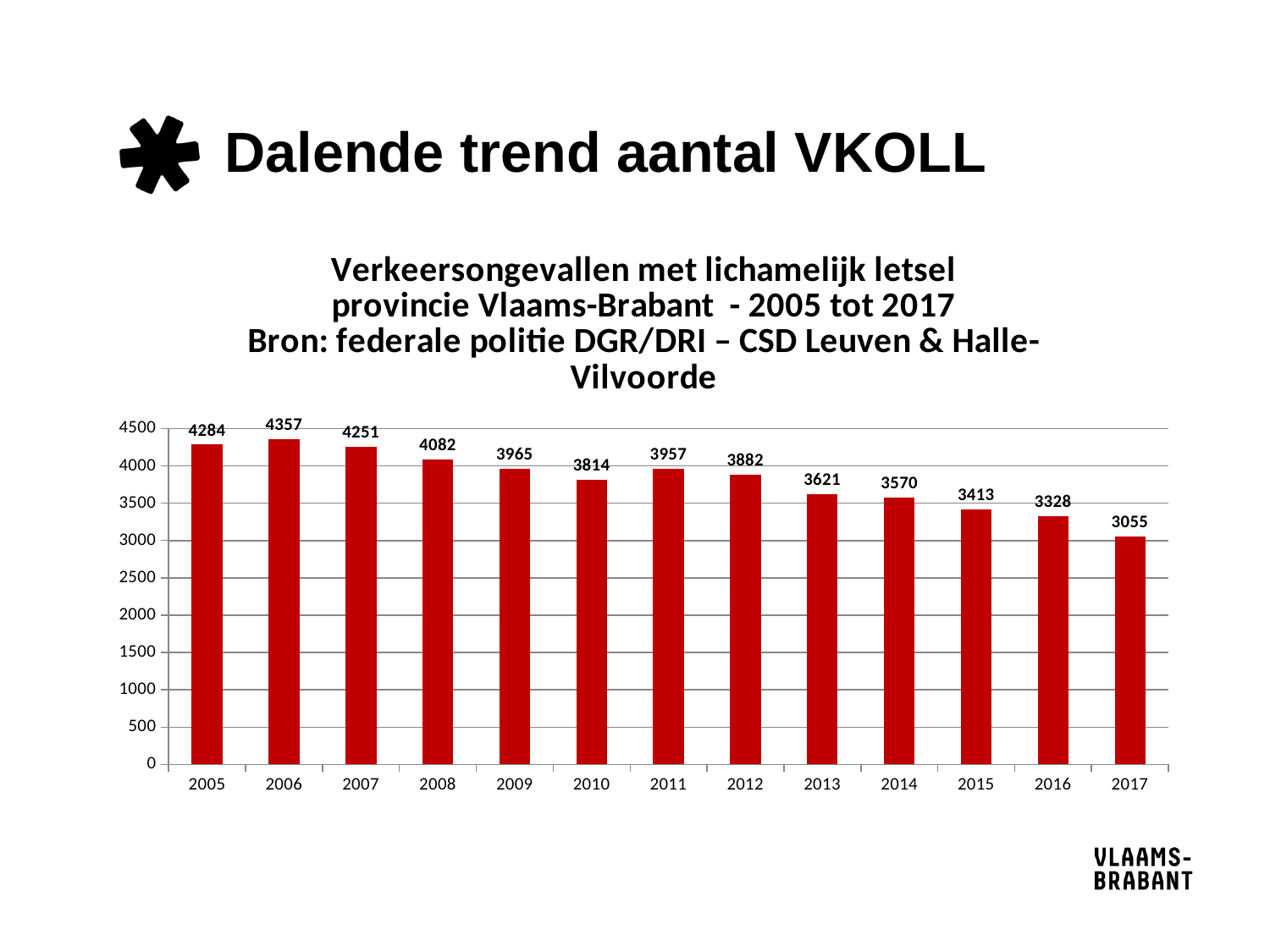
What is the value for 2017? 3055 How many years are shown on the x axis? 13 What is the difference between the values for 2006 and 2017? 1302 Which year has the highest value? 2006 Do the values generally rise or fall from 2005 to 2017? fall What is the difference between the values for 2010 and 2011? 143 Which year has the lowest value? 2017 Which is larger, the value for 2009 or the value for 2011? 2009 What is the value for 2005? 4284 What kind of chart is shown? bar chart What is the value for 2012? 3882 Is the value for 2013 greater or less than 4000? less